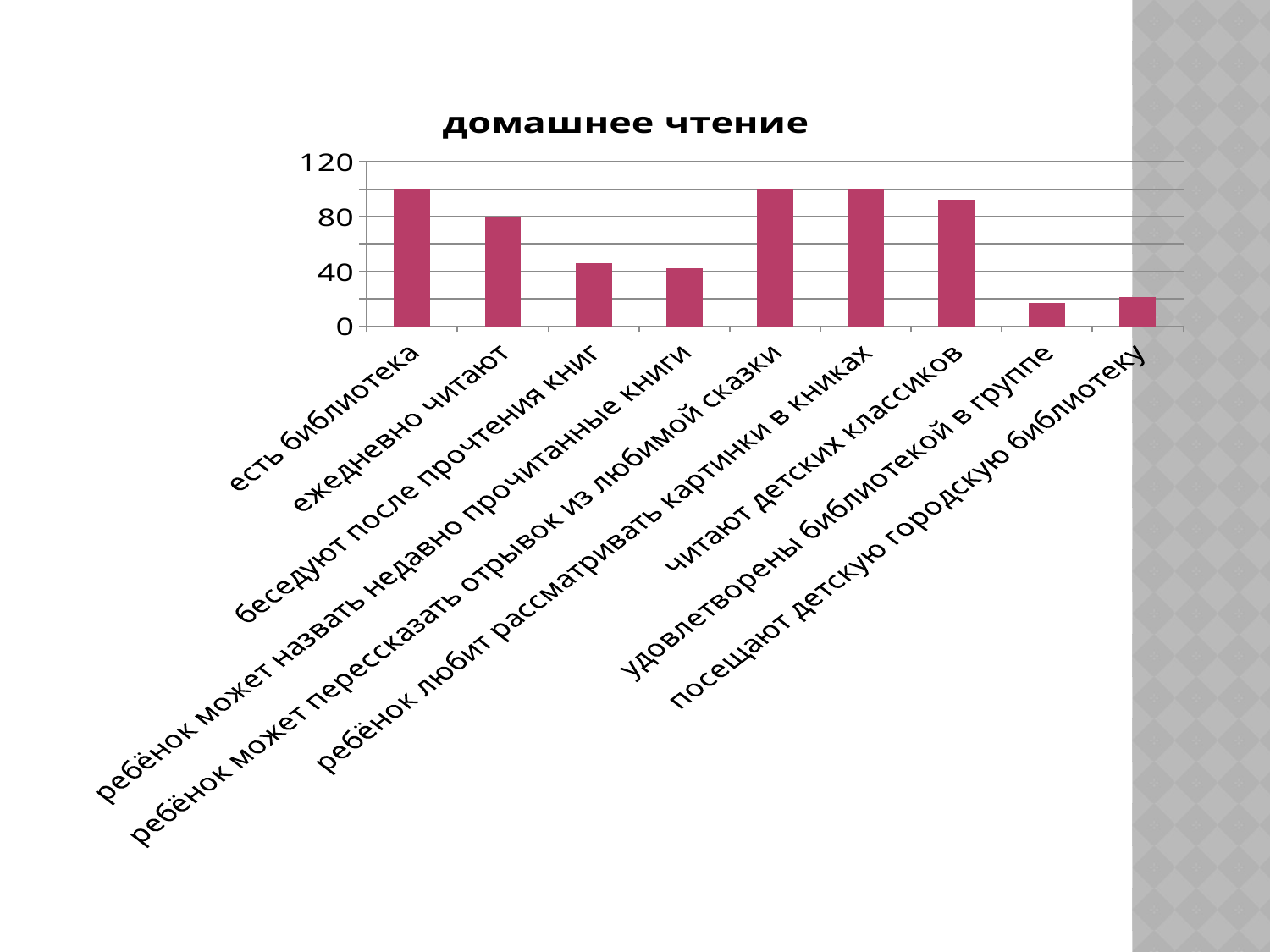
Which is larger: the value for "читают детских классиков" or the value for "беседуют после прочтения книг"? читают детских классиков What colour are the bars in the chart? pink Is the value for "посещают детскую городскую библиотеку" greater or less than 40? less Is the value for "ребёнок может пересказать отрывок из любимой сказки" greater or less than 80? greater Is the value for "удовлетворены библиотекой в группе" greater or less than 40? less How many categories are plotted in the chart? 9 What kind of chart is shown on the slide? bar chart What is the title of the chart? домашнее чтение Which is larger: the value for "есть библиотека" or the value for "ежедневно читают"? есть библиотека Which category has the lowest value? удовлетворены библиотекой в группе